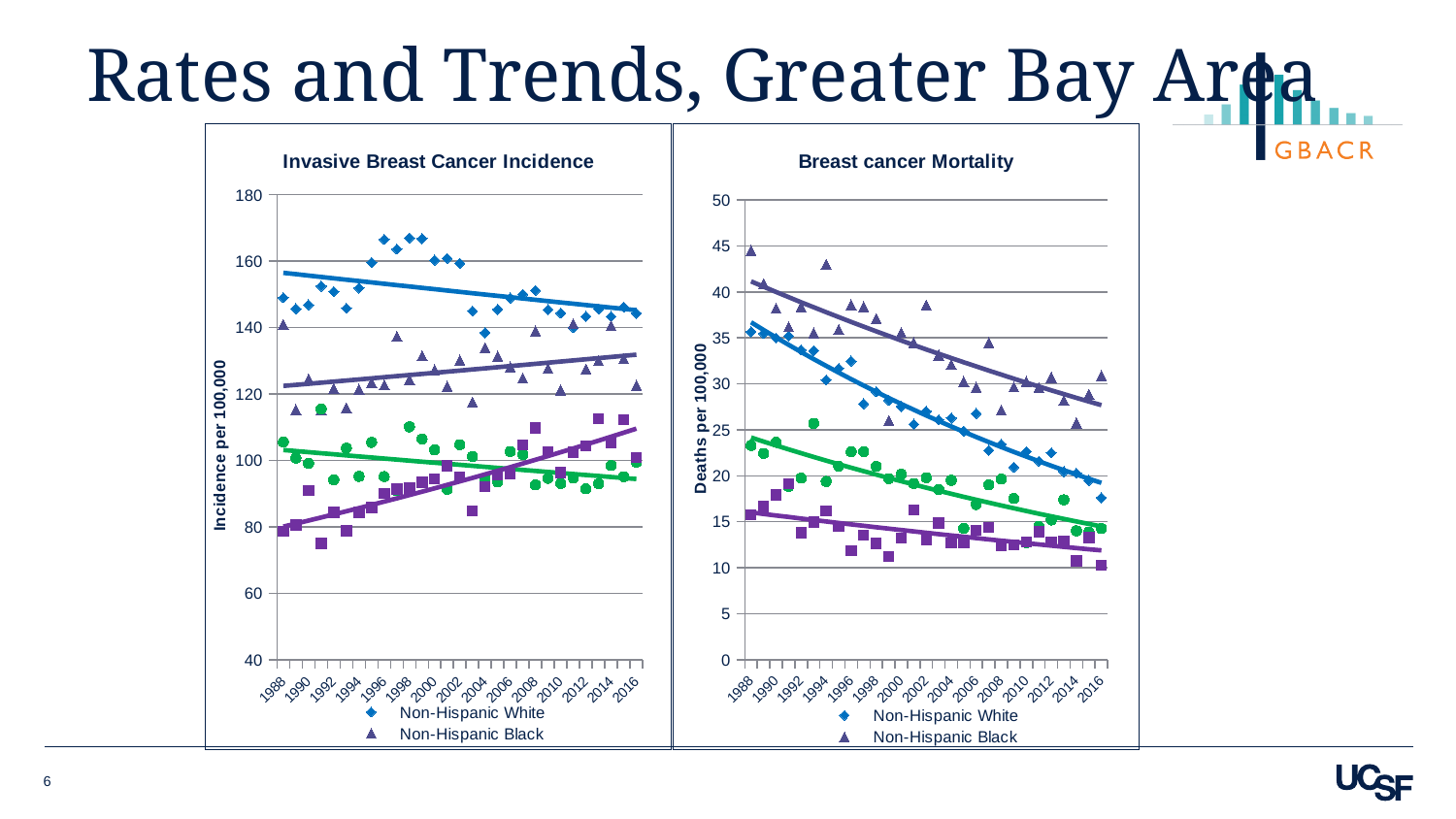
In the Breast cancer Mortality chart, is the Non-Hispanic Black value for 1988 greater or less than 40? greater In the Breast cancer Mortality chart, is the Non-Hispanic White value for 2016 greater or less than 20? less In the Invasive Breast Cancer Incidence chart, is the Non-Hispanic White value for 1988 greater or less than 140? greater In the Breast cancer Mortality chart, does the Non-Hispanic White trend line rise or fall from 1988 to 2016? fall What is the y-axis label of the Invasive Breast Cancer Incidence chart? Incidence per 100,000 What is the y-axis label of the Breast cancer Mortality chart? Deaths per 100,000 What kind of chart is the Invasive Breast Cancer Incidence chart? scatter chart In the Breast cancer Mortality chart, which series has the higher value in 1988, Non-Hispanic White or Non-Hispanic Black? Non-Hispanic Black In the Invasive Breast Cancer Incidence chart, does the Non-Hispanic Black trend line rise or fall from 1988 to 2016? rise In the Invasive Breast Cancer Incidence chart, does the Non-Hispanic White trend line rise or fall from 1988 to 2016? fall